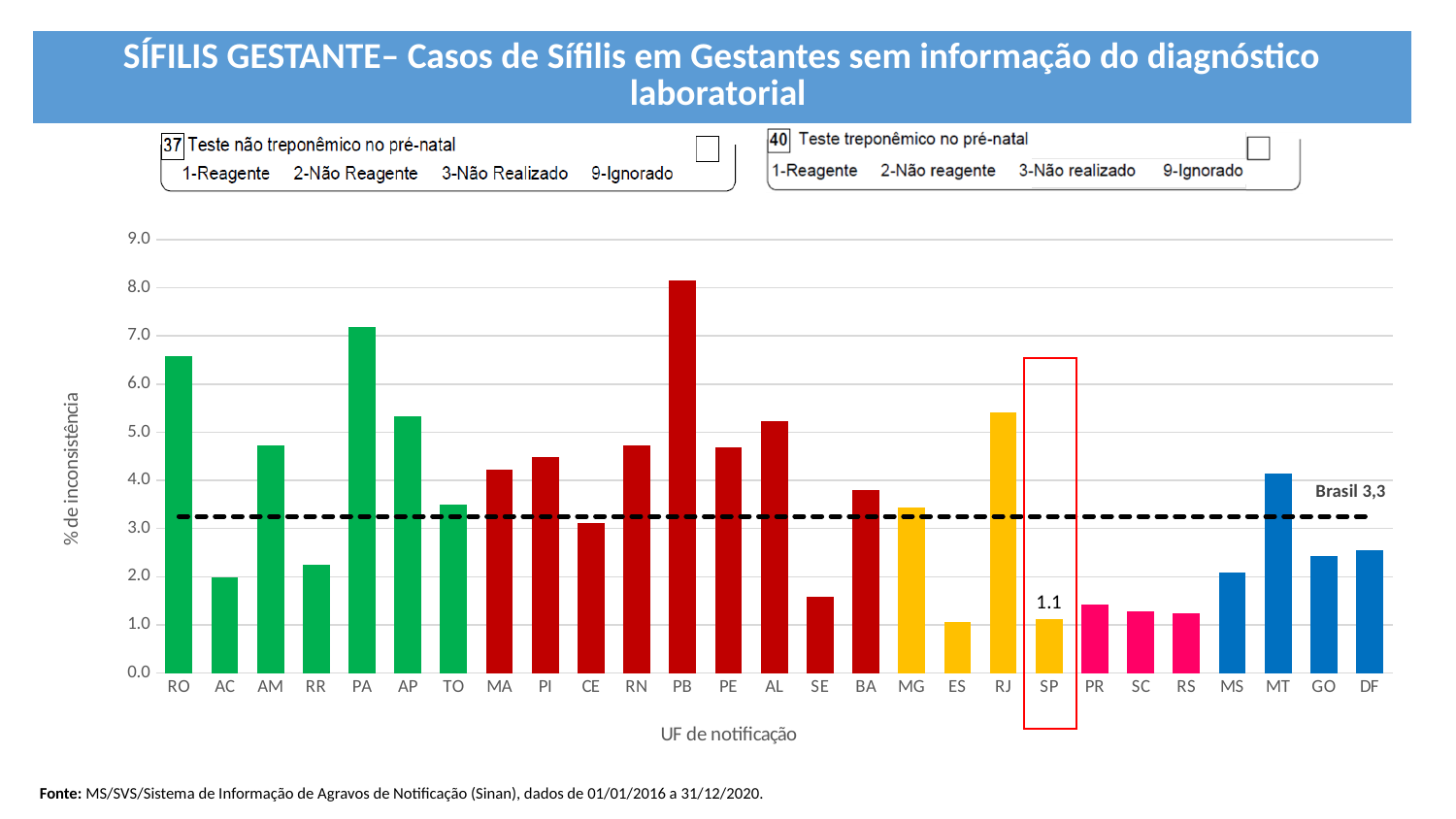
What value is given for Brasil by the dashed reference line? 3,3 Which UF has the highest % de inconsistência? PB Is the value for RO greater or less than 6.0? greater Which has a higher value, RO or PA? PA Is the value for SE greater or less than 2.0? less Which has a higher value, MG or ES? MG Is the value for RJ greater or less than 5.0? greater What is the value shown for SP? 1.1 What type of chart is shown on the slide? bar chart How many UFs (categories) are plotted on the x axis? 27 What is the title of the x axis? UF de notificação